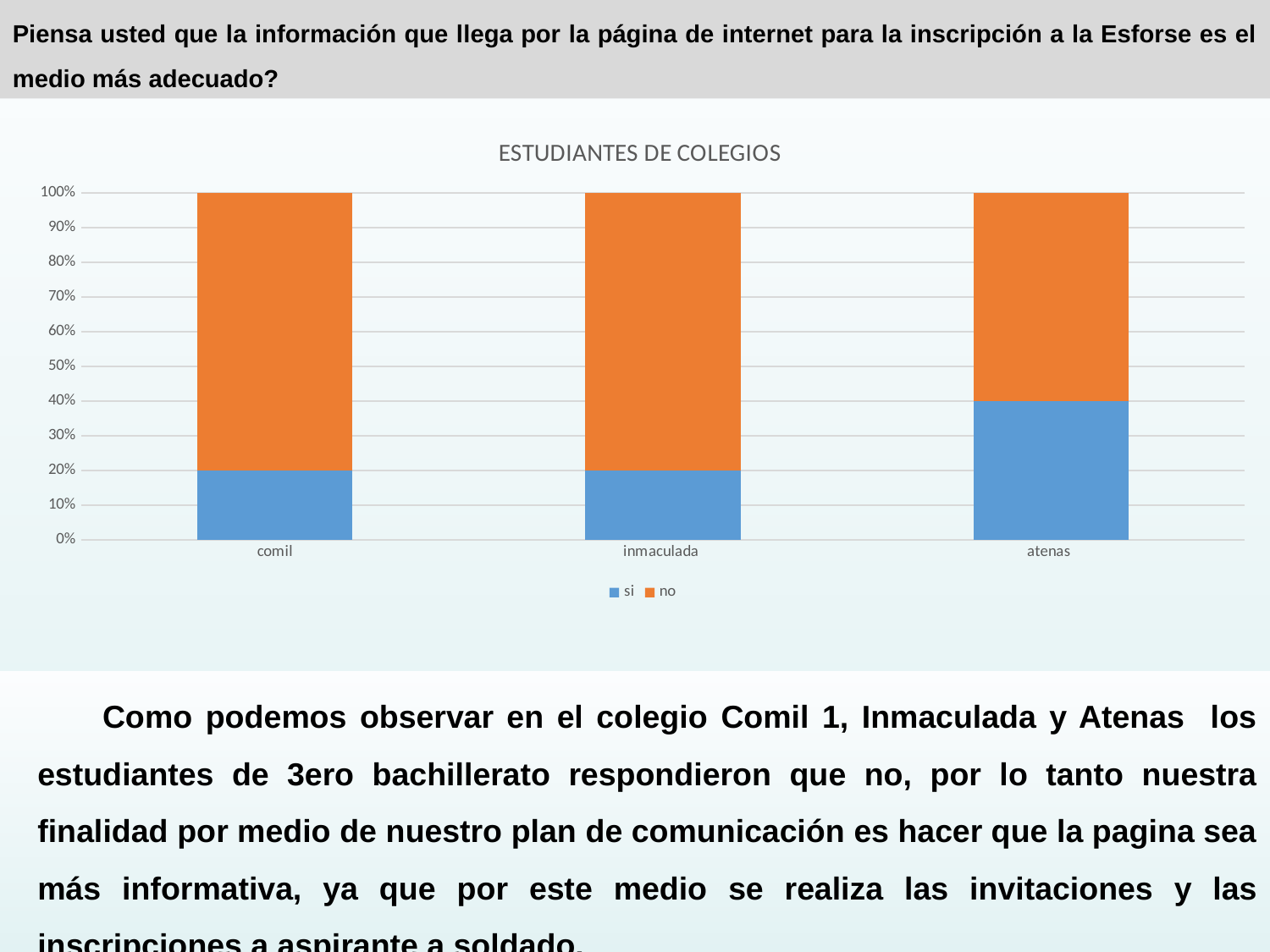
Is the "no" value for comil greater or less than 70%? greater What kind of chart is shown on the slide? stacked bar chart How many categories are shown on the x axis? 3 What is the value of the "si" series for comil? 20% How many series does the legend list? 2 What is the value of the "si" series for inmaculada? 20% Which is larger, the "si" value for atenas or the "si" value for comil? atenas What is the title of the chart? ESTUDIANTES DE COLEGIOS Is the "no" value for atenas greater or less than 50%? greater What is the total of the stacked bar for inmaculada? 100% Which category has the highest "si" value? atenas What is the value of the "si" series for atenas? 40%